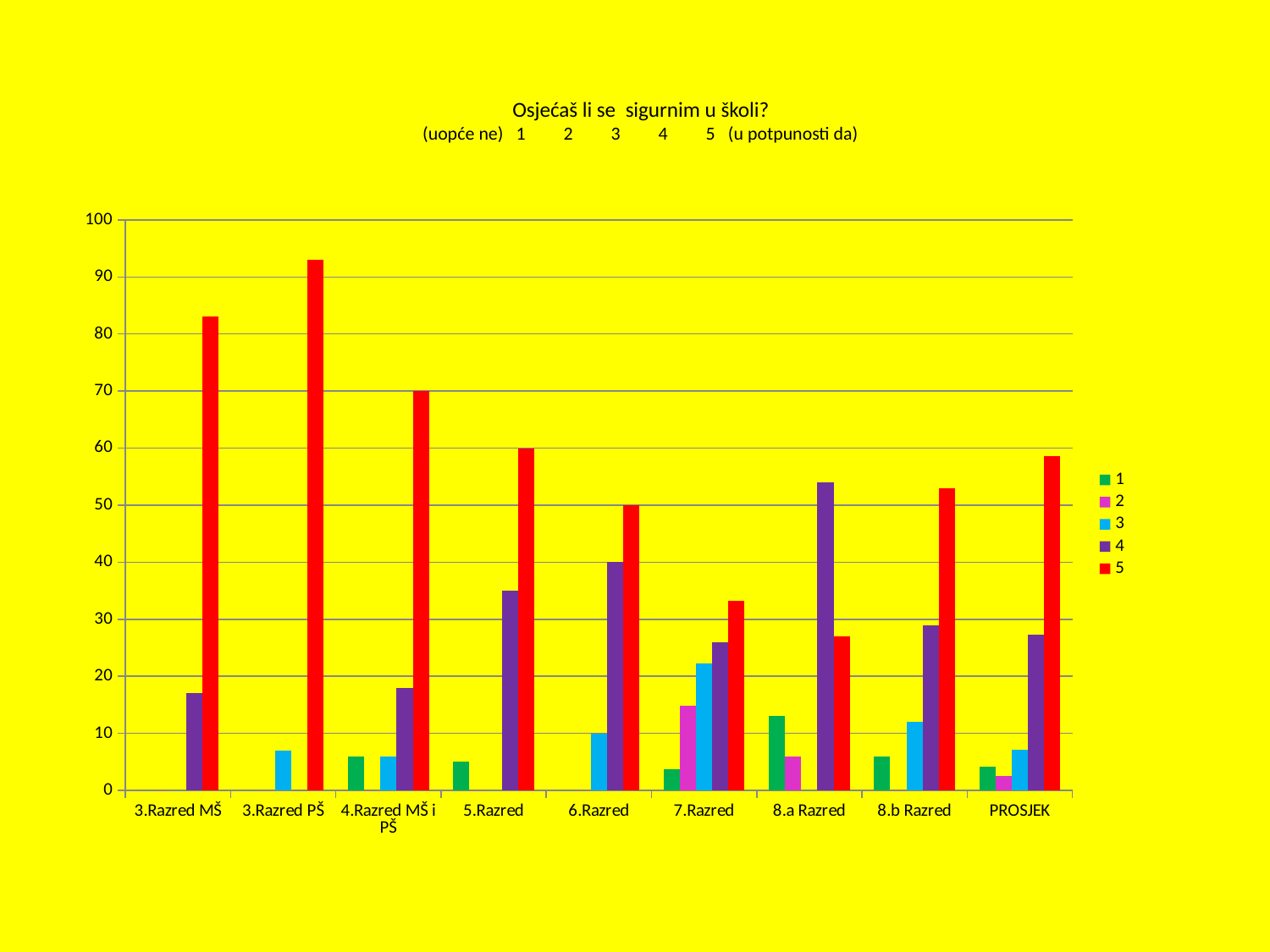
In 7.Razred, which is larger: series 2 or series 3? series 3 In 8.a Razred, which is larger: series 4 or series 5? series 4 Which category has the highest value for series 5? 3.Razred PŠ What is the title of the chart? Osjećaš li se sigurnim u školi? Is the value for series 5 in PROSJEK greater or less than 50? greater Which category has the lowest value for series 5? 8.a Razred How many series does the legend list? 5 Is the value for series 5 in 3.Razred MŠ greater or less than 80? greater How many categories are shown along the x axis? 9 What kind of chart is shown on the slide? bar chart Is the value for series 5 in 3.Razred PŠ greater or less than 90? greater